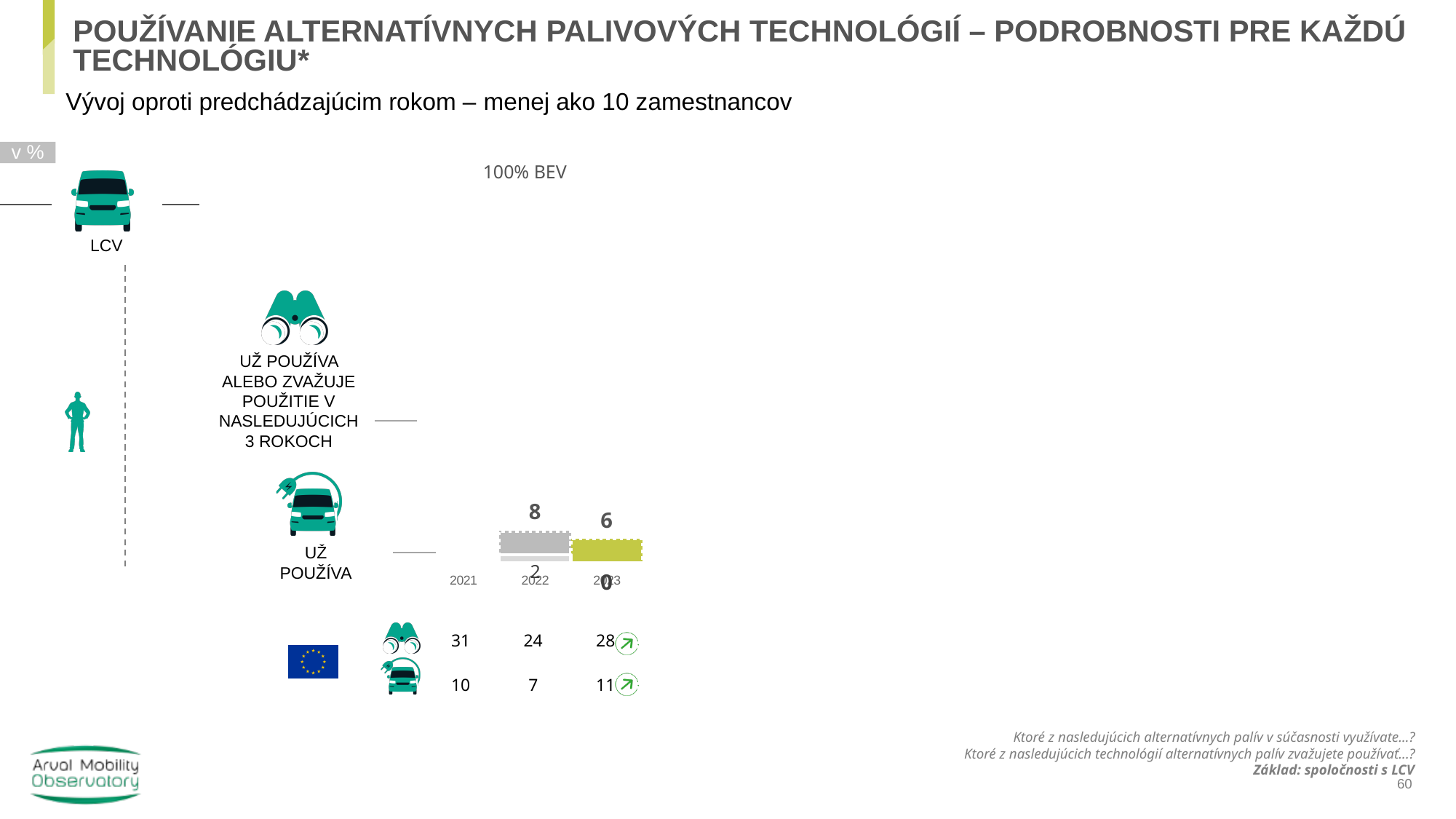
In the EU reference row with the binoculars icon, what is the value for 2021? 31 In the "100% BEV" chart, what is the value of the grey bar for 2022? 8 In the "100% BEV" chart, what is the value of the yellow-green bar for 2023? 6 In the "100% BEV" chart, does the bar value rise or fall from 2022 to 2023? fall In the "100% BEV" chart, which year has the higher bar, 2022 or 2023? 2022 In the "100% BEV" chart, what is the difference between the 2022 bar (8) and the 2023 bar (6)? 2 In the EU reference row with the electric vehicle icon, what is the value for 2023? 11 What type of chart is shown under the heading "100% BEV"? bar chart How many years are labelled on the x axis of the "100% BEV" chart? 3 Which years are labelled on the x axis of the "100% BEV" chart? 2021, 2022, 2023 What is the title shown above the bar chart? 100% BEV In the EU reference row with the binoculars icon, which year has the lowest value? 2022